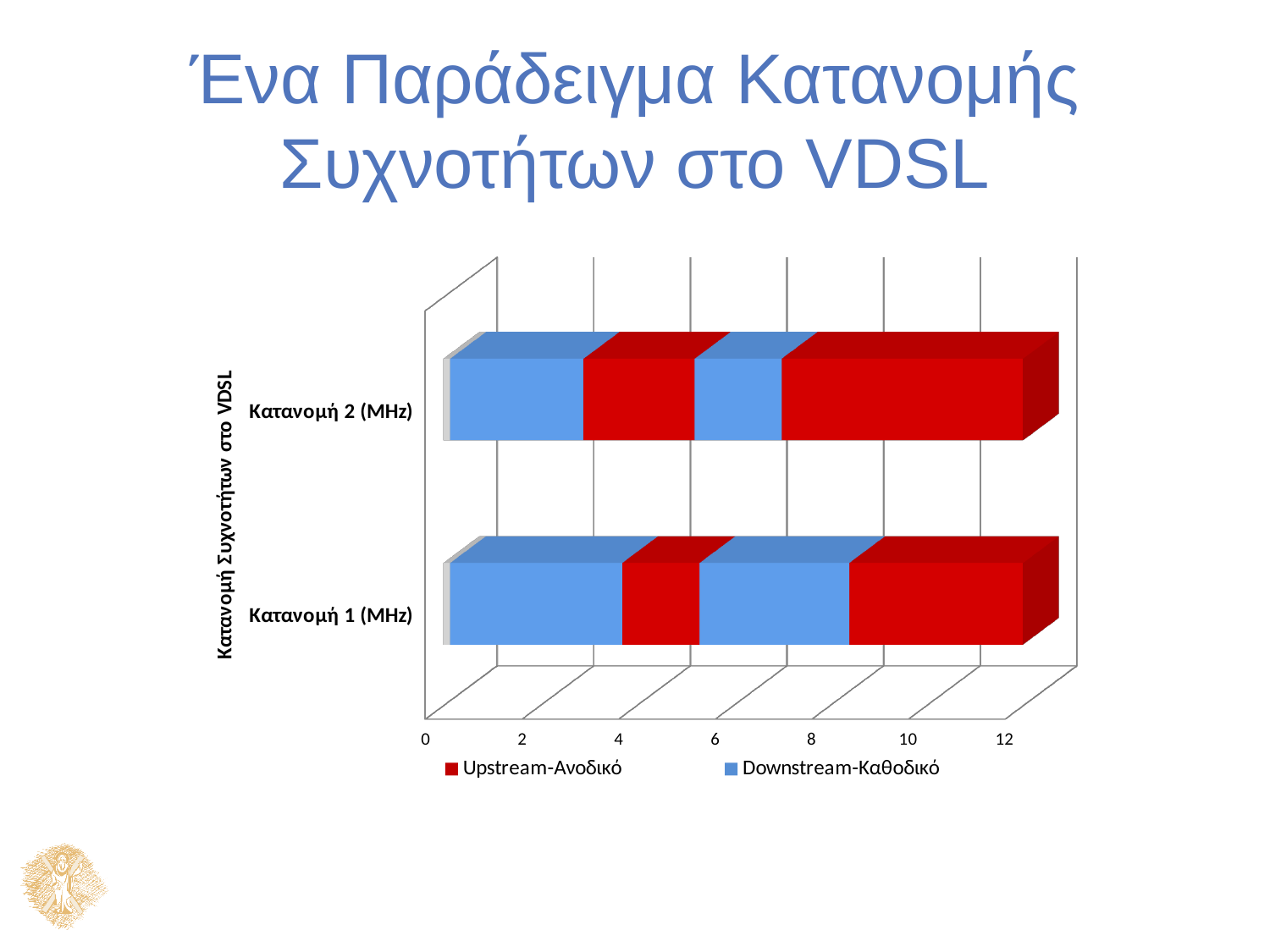
Is the first Downstream-Καθοδικό segment of the Κατανομή 2 (MHz) bar greater or less than 2? greater Is the first Downstream-Καθοδικό segment of the Κατανομή 2 (MHz) bar greater or less than 4? less How many series does the chart legend list? 2 Is the total length of the bar for Κατανομή 1 (MHz) greater or less than 10? greater Which series is shown in red in the chart? Upstream-Ανοδικό What is the title of the vertical axis of the chart? Κατανομή Συχνοτήτων στο VDSL What is the highest value shown on the horizontal axis of the chart? 12 How many categories are plotted on the vertical axis of the chart? 2 What kind of chart is shown on the slide? Stacked bar chart